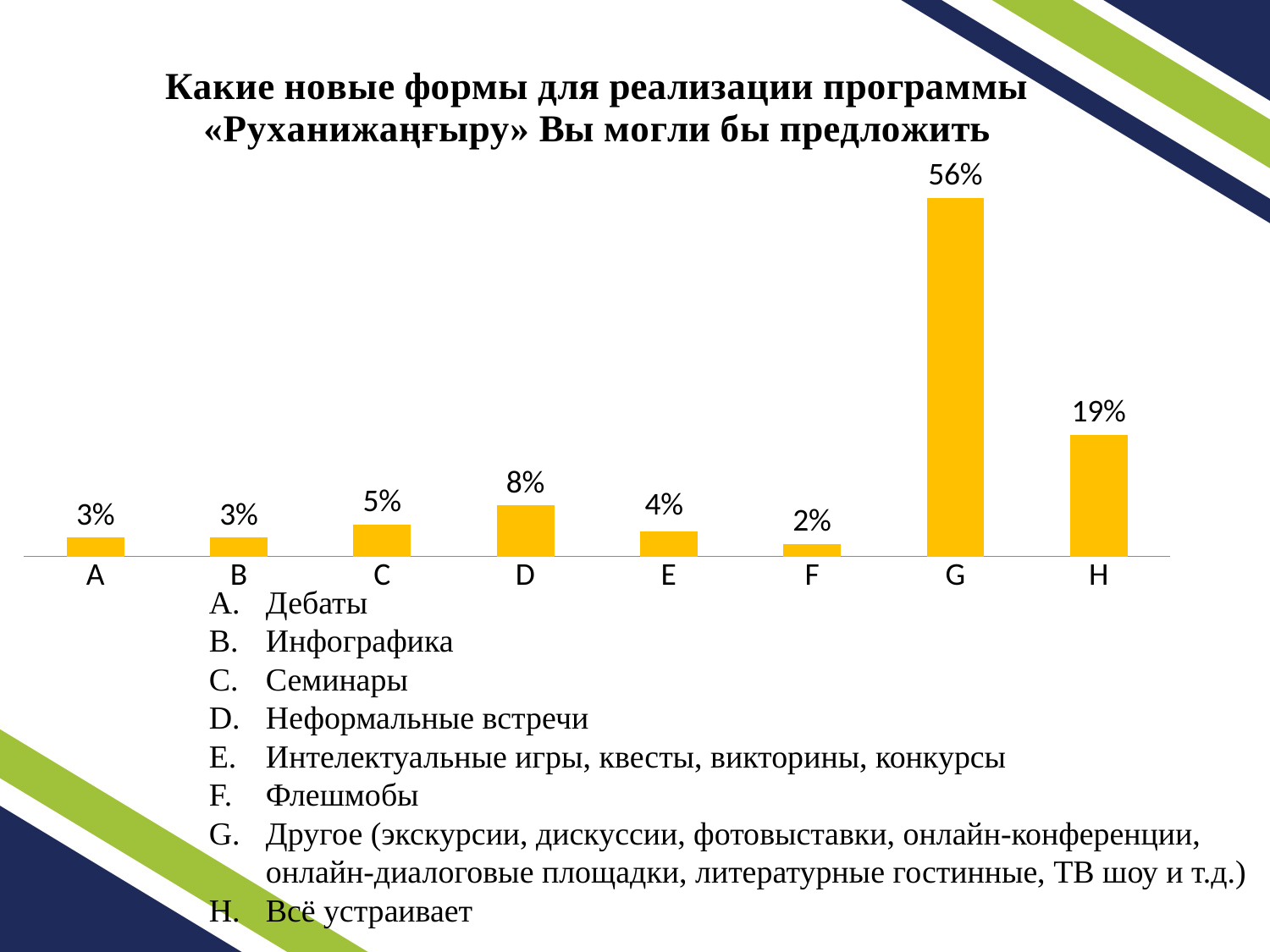
Which category has the highest value? G What is the value for category D? 8% What is the value for category F? 2% What kind of chart is shown on the slide? Bar chart What is the value for category G? 56% What colour are the bars in the chart? Yellow How many categories are shown on the x axis? 8 What is the difference between the values for D and C? 3% Which category has the lowest value? F What is the difference between the values for G and H? 37% Which is larger, the value for C or the value for E? C What is the value for category H? 19%